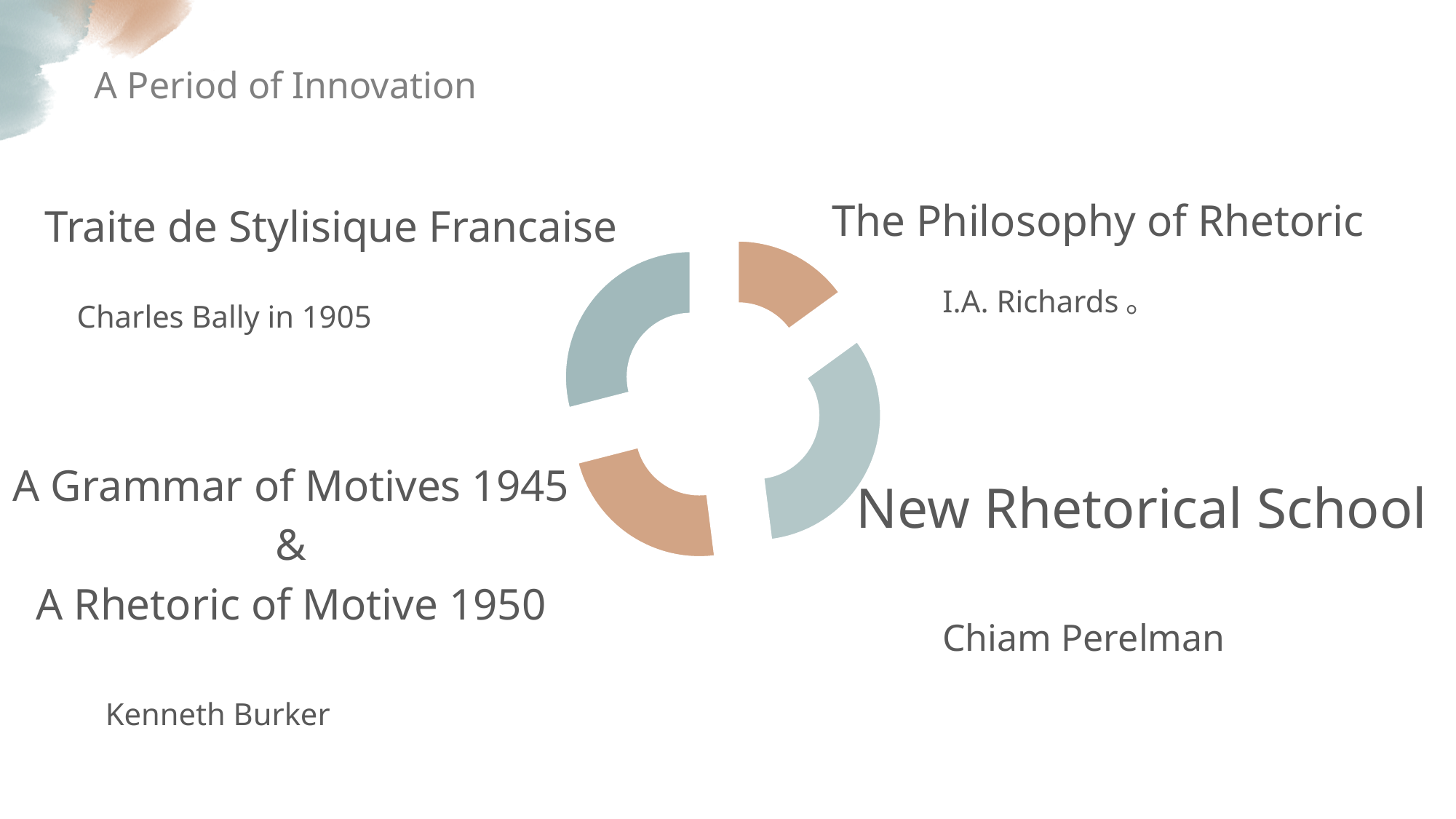
How many segments does the doughnut chart in the centre of the slide have? 4 Does the doughnut chart on the slide show any data labels? No What kind of chart is shown in the centre of the slide? doughnut chart Does the doughnut chart on the slide have a legend? No Which segment of the doughnut chart is the smallest? the top-right orange segment